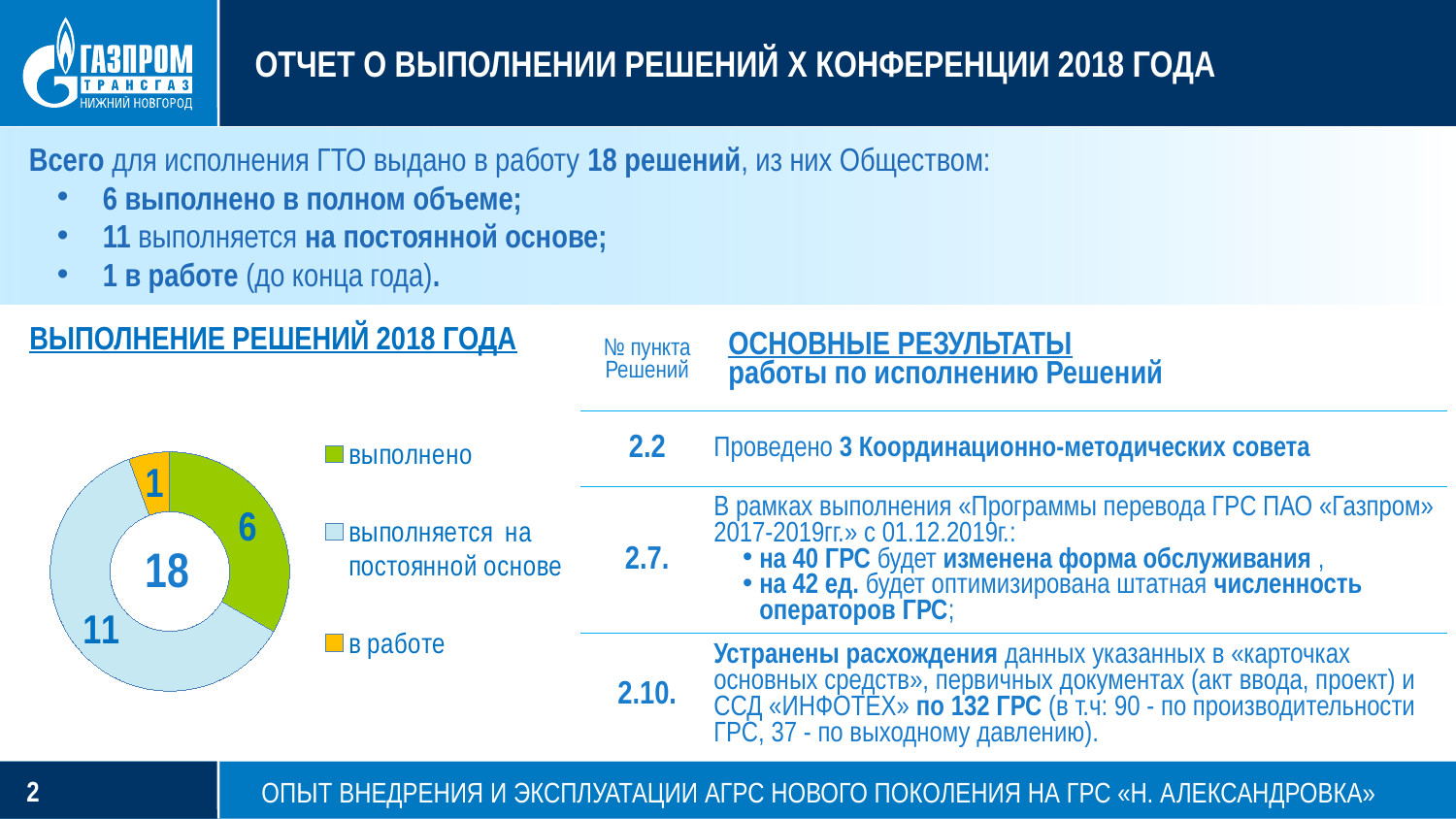
What is the title of the chart on the slide? ВЫПОЛНЕНИЕ РЕШЕНИЙ 2018 ГОДА Which category has the smallest value in the doughnut chart? в работе Which category has the largest value in the doughnut chart? выполняется на постоянной основе Which is larger in the doughnut chart: "выполнено" or "в работе"? выполнено What total is shown in the centre of the doughnut chart? 18 What colour represents "в работе" in the doughnut chart? orange How many categories does the doughnut chart show? 3 What is the value for "выполняется на постоянной основе" in the doughnut chart? 11 What is the value for "выполнено" in the doughnut chart? 6 What is the difference between the values for "выполняется на постоянной основе" and "выполнено"? 5 What kind of chart is shown on the slide? doughnut chart What is the value for "в работе" in the doughnut chart? 1